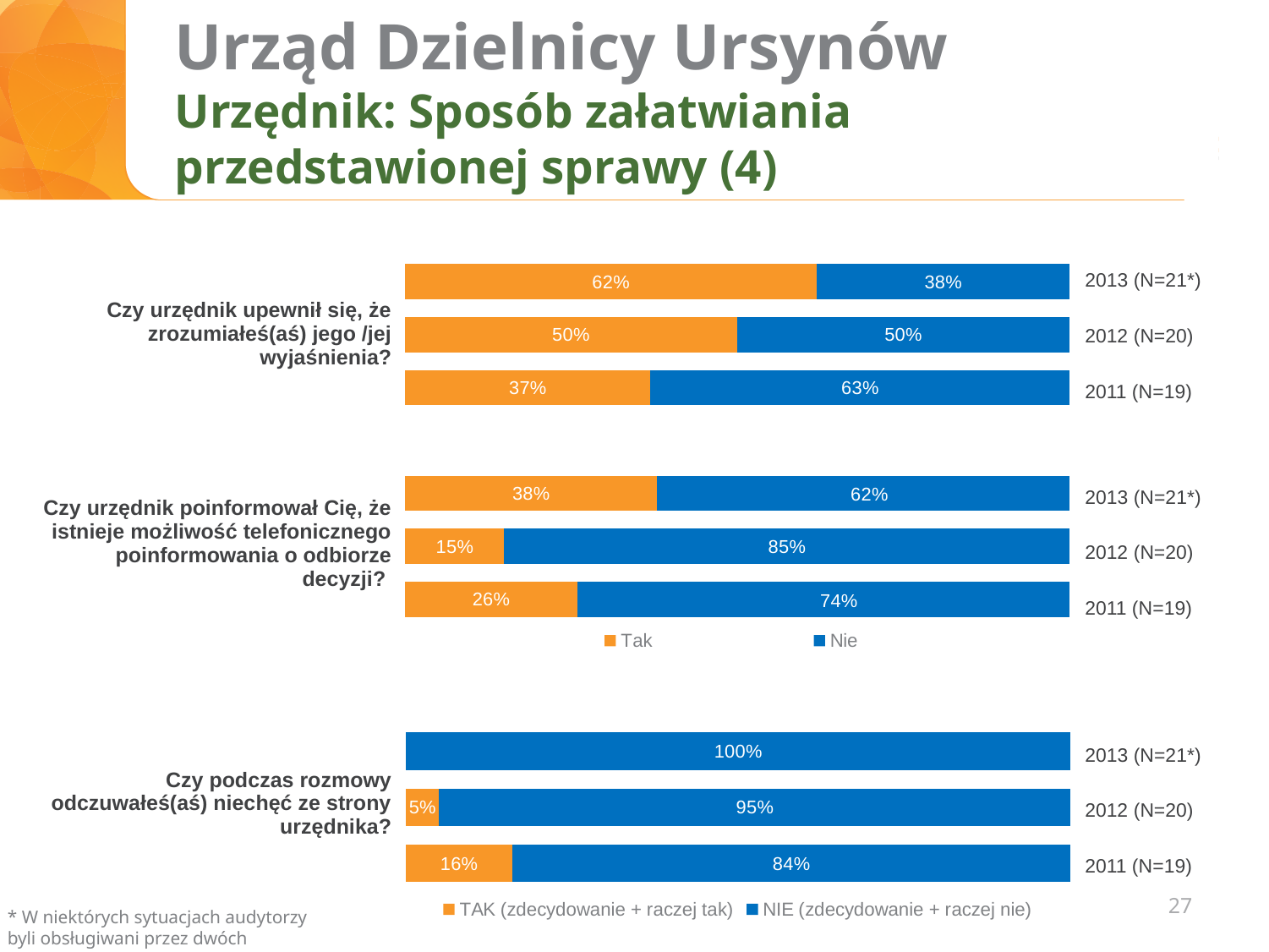
How many years (bars) are shown in the chart for "Czy podczas rozmowy odczuwałeś(aś) niechęć ze strony urzędnika?"? 3 What type of chart is used for "Czy urzędnik poinformował Cię, że istnieje możliwość telefonicznego poinformowania o odbiorze decyzji?"? Stacked bar chart How many series does the legend below the chart for "Czy podczas rozmowy odczuwałeś(aś) niechęć ze strony urzędnika?" list? 2 In the chart for "Czy urzędnik poinformował Cię, że istnieje możliwość telefonicznego poinformowania o odbiorze decyzji?", what is the Nie value for 2012 (N=20)? 85% In the chart for "Czy urzędnik poinformował Cię, że istnieje możliwość telefonicznego poinformowania o odbiorze decyzji?", which year has the highest Tak value? 2013 (N=21*) In the chart for "Czy urzędnik upewnił się, że zrozumiałeś(aś) jego /jej wyjaśnienia?", how does the Tak value change from 2011 to 2013? It rises In the chart for "Czy urzędnik poinformował Cię, że istnieje możliwość telefonicznego poinformowania o odbiorze decyzji?", which year has the lowest Tak value? 2012 (N=20) In the chart for "Czy urzędnik upewnił się, że zrozumiałeś(aś) jego /jej wyjaśnienia?", what is the Nie value for 2011 (N=19)? 63% In the chart for "Czy podczas rozmowy odczuwałeś(aś) niechęć ze strony urzędnika?", what is the NIE value for 2013 (N=21*)? 100% In the chart for "Czy podczas rozmowy odczuwałeś(aś) niechęć ze strony urzędnika?", what is the difference between the NIE values for 2012 (N=20) and 2011 (N=19)? 11% In the chart for "Czy urzędnik upewnił się, że zrozumiałeś(aś) jego /jej wyjaśnienia?", what is the Tak value for 2013 (N=21*)? 62% In the chart for "Czy urzędnik upewnił się, że zrozumiałeś(aś) jego /jej wyjaśnienia?", is the Tak value larger for 2013 (N=21*) or 2011 (N=19)? 2013 (N=21*)